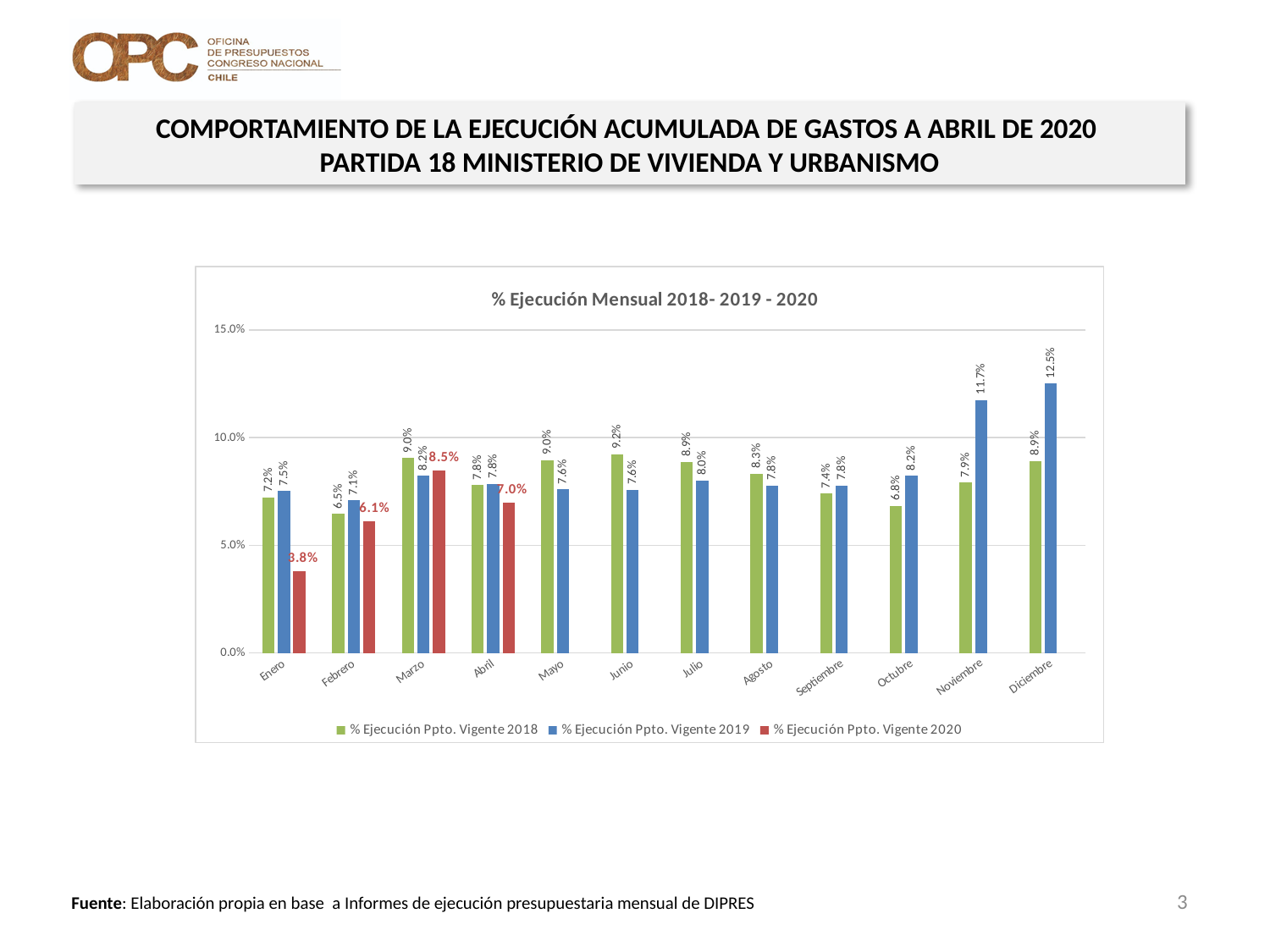
How many series does the legend list? 3 What is the value for % Ejecución Ppto. Vigente 2018 in Junio? 9.2% Which month has the highest value for % Ejecución Ppto. Vigente 2019? Diciembre What is the difference between the 2019 and 2018 values in Noviembre? 3.8% In Marzo, which is larger: the 2018 value or the 2020 value? 2018 value (9.0%) What is the title of the chart? % Ejecución Mensual 2018- 2019 - 2020 Which month has the lowest value for % Ejecución Ppto. Vigente 2018? Febrero How many months are shown on the x axis? 12 What is the value for % Ejecución Ppto. Vigente 2020 in Enero? 3.8% Do the % Ejecución Ppto. Vigente 2020 values rise or fall from Enero to Marzo? Rise What is the value for % Ejecución Ppto. Vigente 2019 in Diciembre? 12.5% What kind of chart is shown on the slide? Bar chart